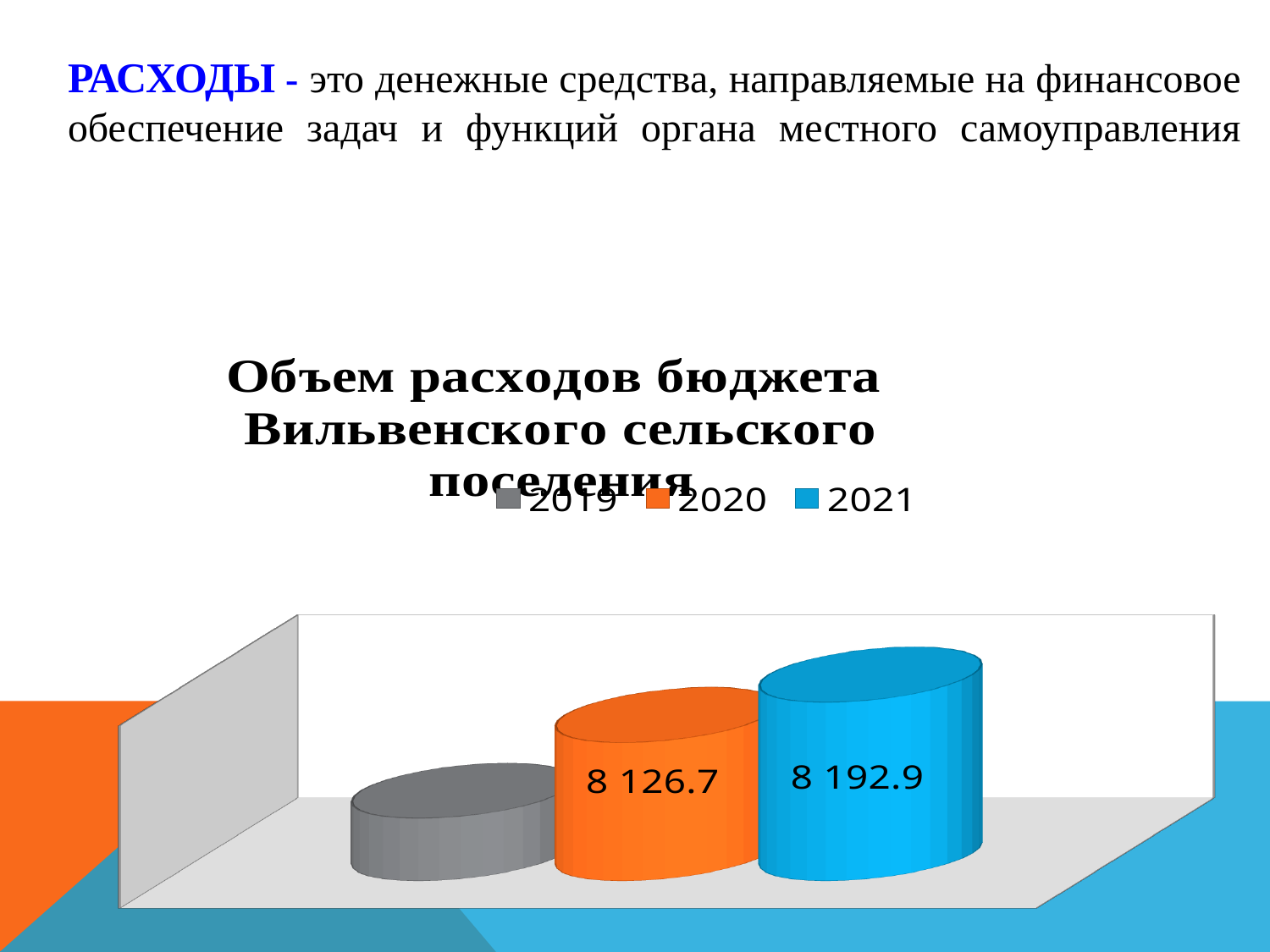
Which year has the highest budget expenditure on the chart? 2021 What is the difference between the values for 2021 and 2020? 66.2 What kind of chart is shown on the slide? bar chart Which colour represents 2020 in the legend? orange Which is larger, the value for 2020 or the value for 2021? 2021 What is the value shown for 2020 on the chart? 8 126.7 What is the value shown for 2021 on the chart? 8 192.9 Which year has the lowest budget expenditure on the chart? 2019 Do the values rise or fall from 2019 to 2021? rise How many bars are plotted on the chart? 3 What is the title of the chart? Объем расходов бюджета Вильвенского сельского поселения How many series does the legend list? 3